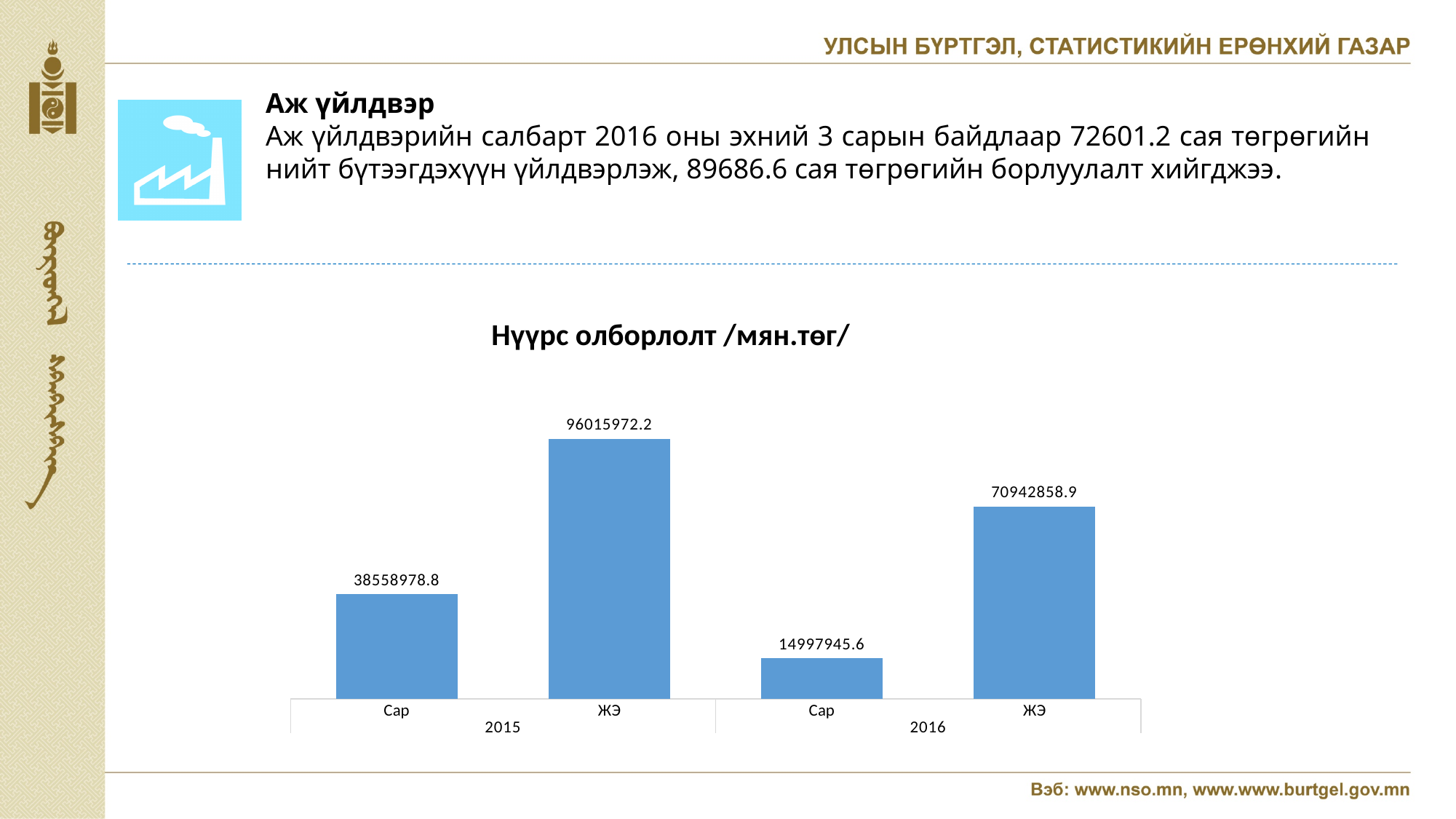
Which bar has the highest value? ЖЭ 2015 What is the value for ЖЭ in 2015? 96015972.2 What is the difference between ЖЭ and Сар in 2016? 55944913.3 What is the value for Сар in 2015? 38558978.8 What is the value for Сар in 2016? 14997945.6 Which is larger, the ЖЭ value in 2015 or the ЖЭ value in 2016? ЖЭ 2015 What is the title of the chart? Нүүрс олборлолт /мян.төг/ Which bar has the lowest value? Сар 2016 What is the difference between the Сар value in 2015 and the Сар value in 2016? 23561033.2 What is the difference between ЖЭ and Сар in 2015? 57456993.4 What is the value for ЖЭ in 2016? 70942858.9 How many bars are plotted in the chart? 4